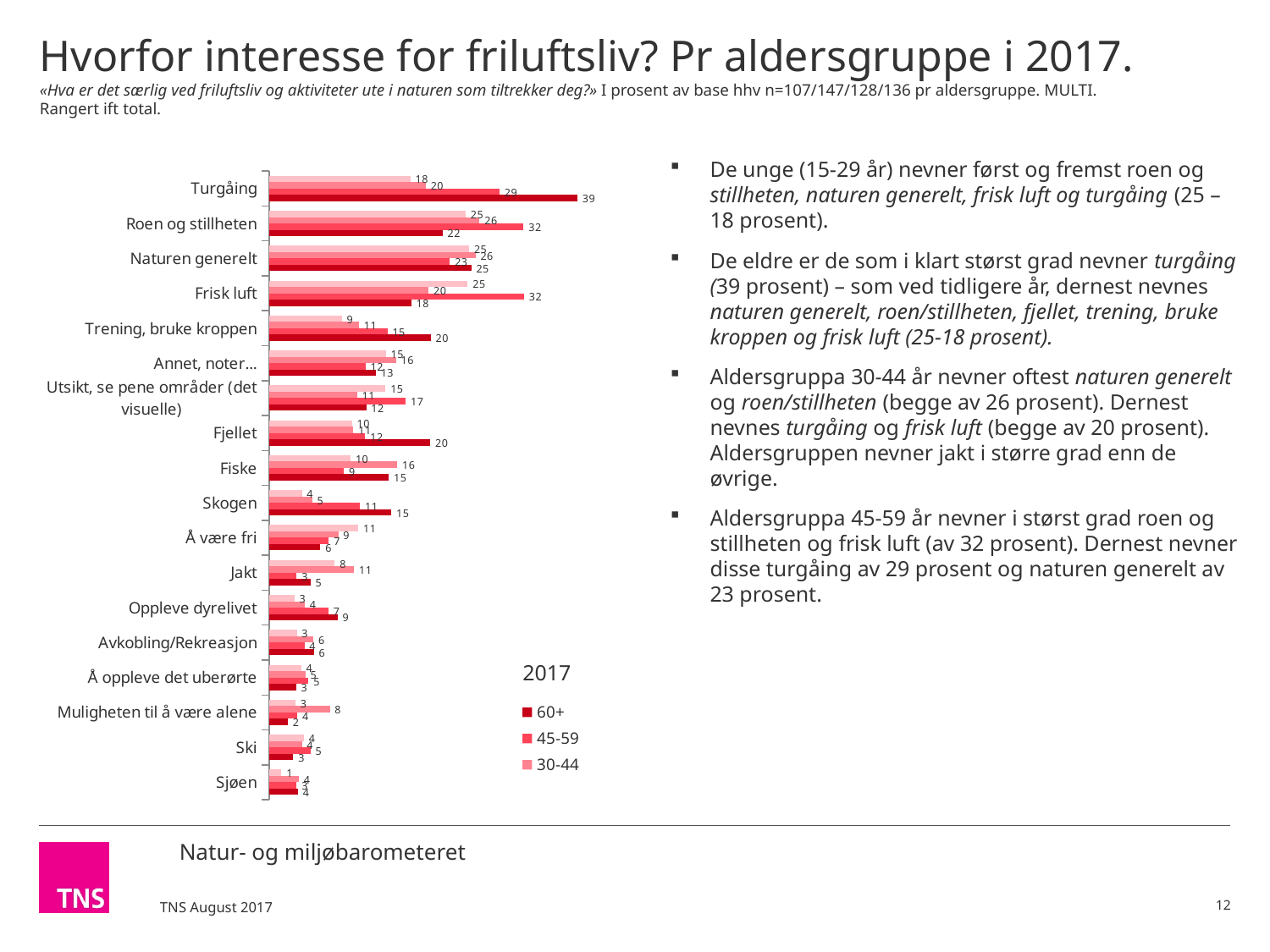
For Roen og stillheten, which is larger: the 45-59 value or the 60+ value? 45-59 What is the difference between the 45-59 and 60+ values for Frisk luft? 14 What is the value for the 45-59 age group for Frisk luft? 32 What kind of chart is shown on the slide? Bar chart For Skogen, which is larger: the 60+ value or the 30-44 value? 60+ How many series does the legend list? 3 What is the value for the 60+ age group for Turgåing? 39 What is the value for the 60+ age group for Fjellet? 20 How many categories are shown on the chart? 18 Which category has the highest value for the 60+ age group? Turgåing What is the difference between the 60+ and 45-59 values for Turgåing? 10 What is the value for the 30-44 age group for Jakt? 11